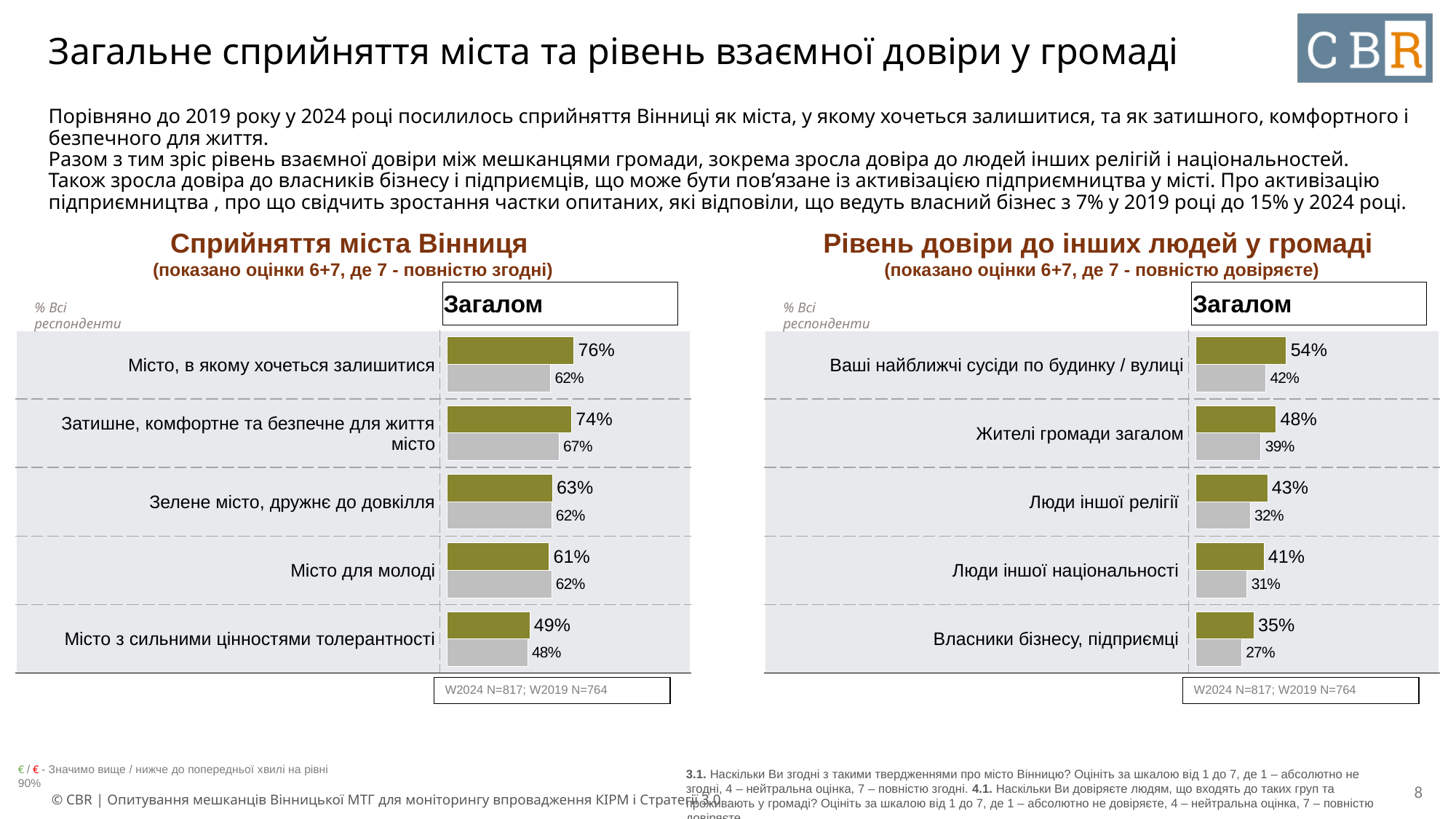
What kind of chart is 'Сприйняття міста Вінниця'? Bar chart In the chart 'Рівень довіри до інших людей у громаді', what is the difference between the 2024 and 2019 values for 'Люди іншої національності'? 10 percentage points In the chart 'Сприйняття міста Вінниця', how many categories are shown? 5 In the chart 'Рівень довіри до інших людей у громаді', which is larger: the 2024 value for 'Жителі громади загалом' or the 2024 value for 'Власники бізнесу, підприємці'? Жителі громади загалом In the chart 'Рівень довіри до інших людей у громаді', what is the 2024 (olive bar) value for 'Люди іншої релігії'? 43% In the chart 'Сприйняття міста Вінниця', which category has the lowest 2024 (olive bar) value? Місто з сильними цінностями толерантності In the chart 'Рівень довіри до інших людей у громаді', which category has the highest 2024 (olive bar) value? Ваші найближчі сусіди по будинку / вулиці In the chart 'Рівень довіри до інших людей у громаді', what is the 2019 (grey bar) value for 'Власники бізнесу, підприємці'? 27% In the chart 'Сприйняття міста Вінниця', what is the 2024 (olive bar) value for 'Місто, в якому хочеться залишитися'? 76% In the chart 'Сприйняття міста Вінниця', what is the 2019 (grey bar) value for 'Затишне, комфортне та безпечне для життя місто'? 67% According to the note under the chart 'Рівень довіри до інших людей у громаді', what is the sample size (N) for W2024? 817 In the chart 'Сприйняття міста Вінниця', what is the difference between the 2024 and 2019 values for 'Місто, в якому хочеться залишитися'? 14 percentage points